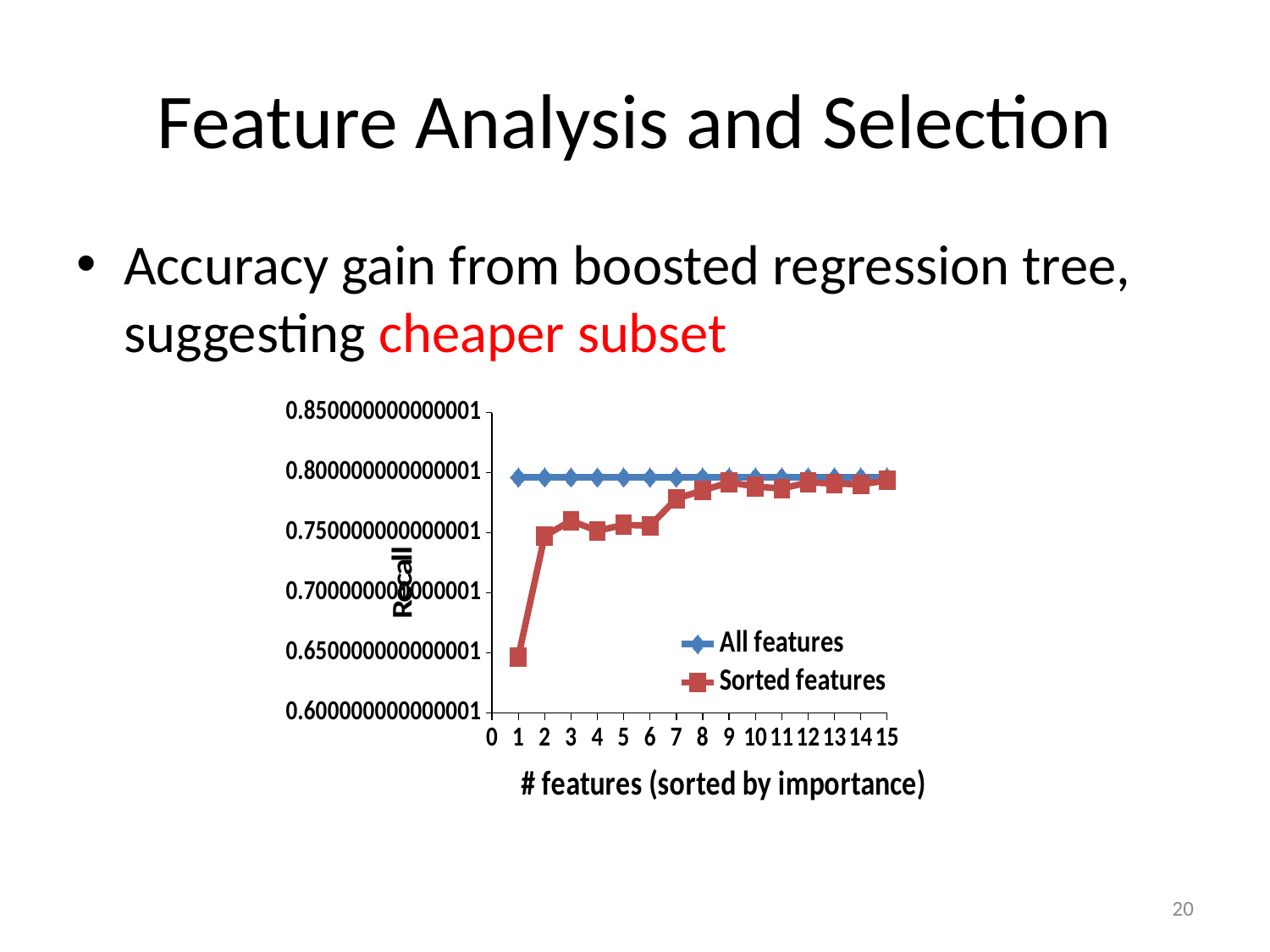
What kind of chart is shown on the slide? line chart Is the Sorted features value at 7 features greater or less than 0.75? greater Is the Sorted features value at 3 features greater or less than 0.75? greater At 1 feature, which series has the higher recall, All features or Sorted features? All features What are the two series named in the legend? All features, Sorted features At which number of features does the Sorted features series reach its lowest recall? 1 Is the Sorted features value at 1 feature greater or less than 0.7? less Does the Sorted features series rise or fall as the number of features increases? rise What is the label of the x axis? # features (sorted by importance) How many series does the legend list? 2